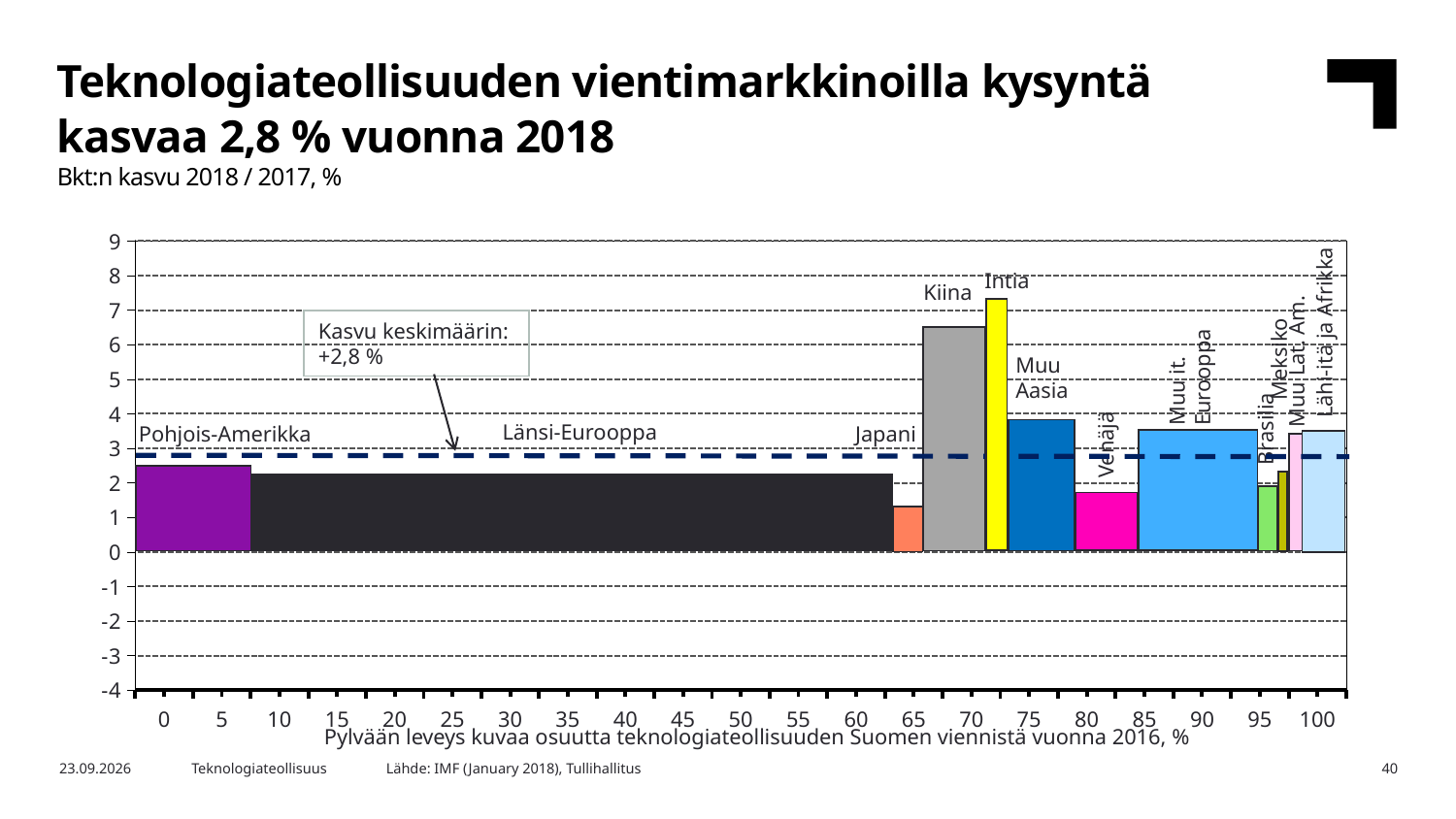
Which has the higher GDP growth, Kiina or Japani? Kiina Which region has the lowest GDP growth in the chart? Japani Which region has the highest GDP growth in the chart? Intia Which has the higher GDP growth, Intia or Kiina? Intia How many regions are shown as bars in the chart? 12 Is the value for Japani greater or less than 2? less Is the value for Kiina greater or less than 5? greater What kind of chart is shown on the slide? bar chart What average growth value does the dashed horizontal line represent, according to the annotation? +2,8 % Is the value for Pohjois-Amerikka greater or less than 3? less